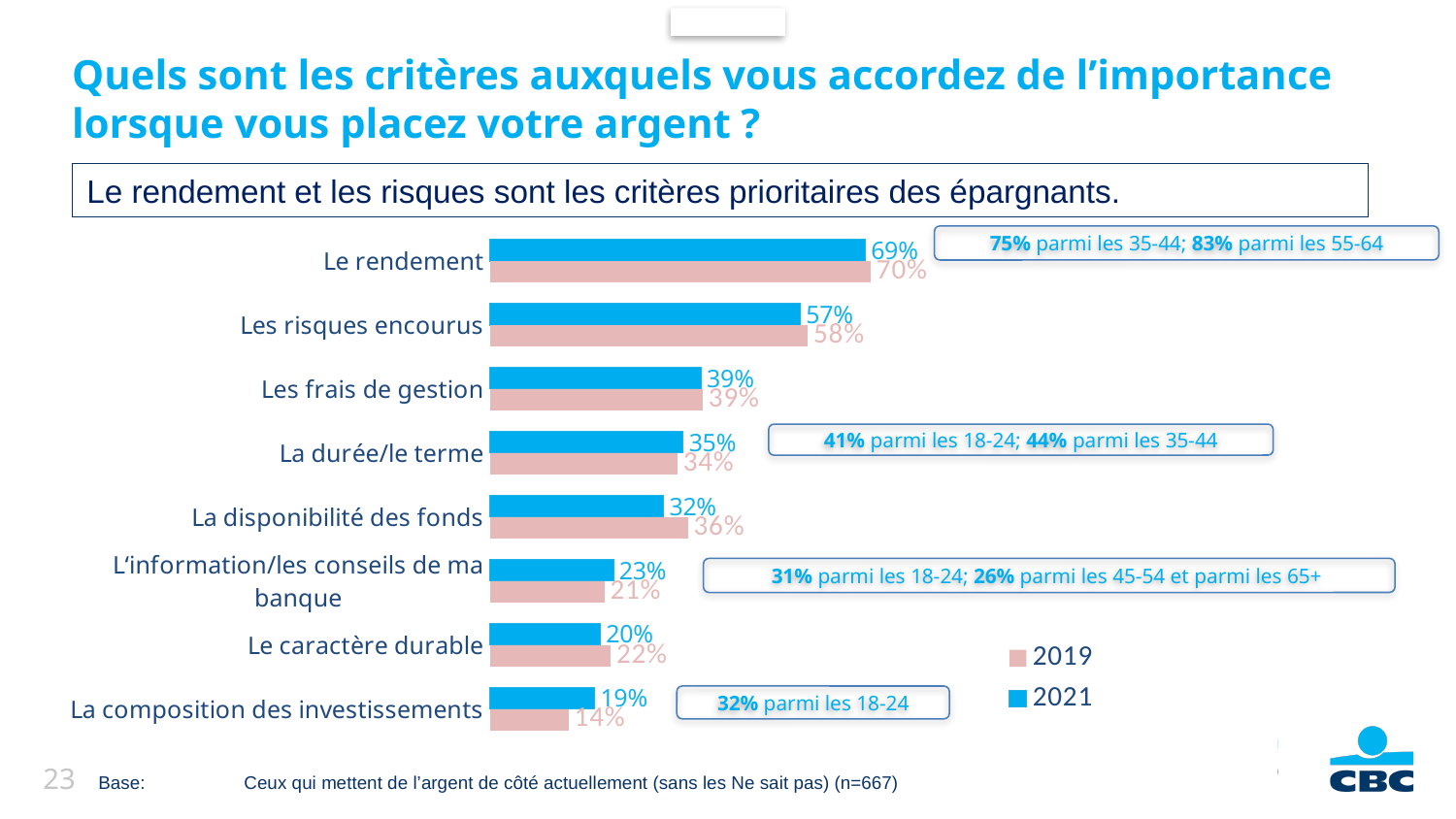
What is the 2019 value for "La disponibilité des fonds"? 36% What is the difference between the 2019 and 2021 values for "La composition des investissements"? 5% What is the 2021 value for "Le rendement"? 69% Which category has the highest 2021 value? Le rendement Which colour represents the 2021 series in the chart? Blue What is the 2019 value for "Les risques encourus"? 58% Which category has the lowest 2019 value? La composition des investissements For "La disponibilité des fonds", which year has the larger value, 2019 or 2021? 2019 How many categories are shown in the chart? 8 What is the 2021 value for "La composition des investissements"? 19% What kind of chart is shown on the slide? Bar chart How many series does the legend list? 2